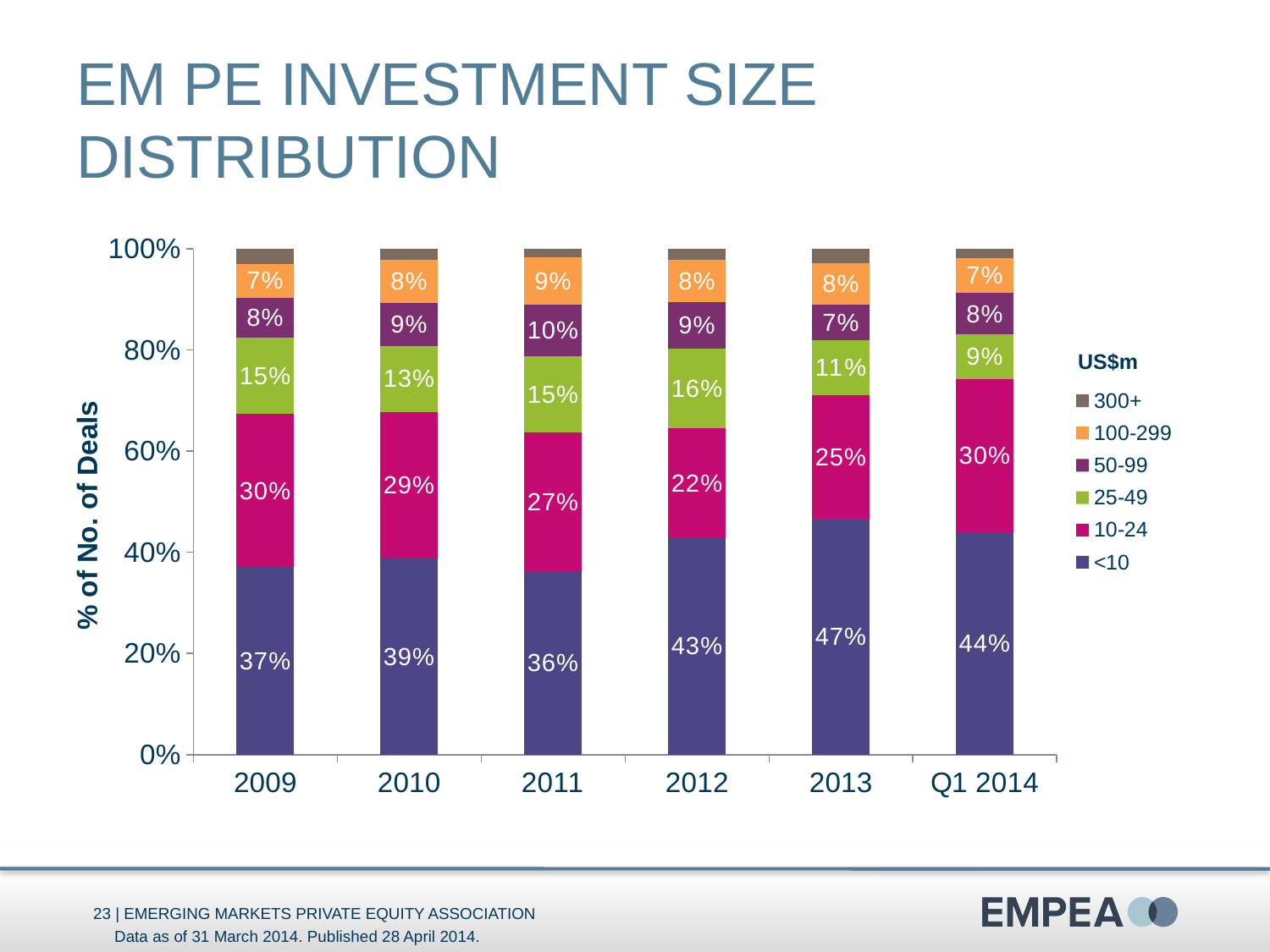
What is the value for the 25-49 US$m bracket in 2012? 16% What is the label on the y axis of the chart? % of No. of Deals In which year does the <10 US$m bracket have its lowest share of deals? 2011 In which year does the <10 US$m bracket have its highest share of deals? 2013 How many investment size brackets does the legend list? 6 What type of chart is shown on the slide? Stacked bar chart By how many percentage points did the <10 US$m share increase from 2009 to 2013? 10 percentage points What percentage of deals in 2013 were in the <10 US$m size bracket? 47% Which year has the larger share of deals in the 10-24 US$m bracket, 2009 or 2013? 2009 What share of deals in 2011 fell in the 10-24 US$m bracket? 27% How many time periods are shown on the x axis? 6 What percentage of deals in Q1 2014 were in the 50-99 US$m bracket? 8%